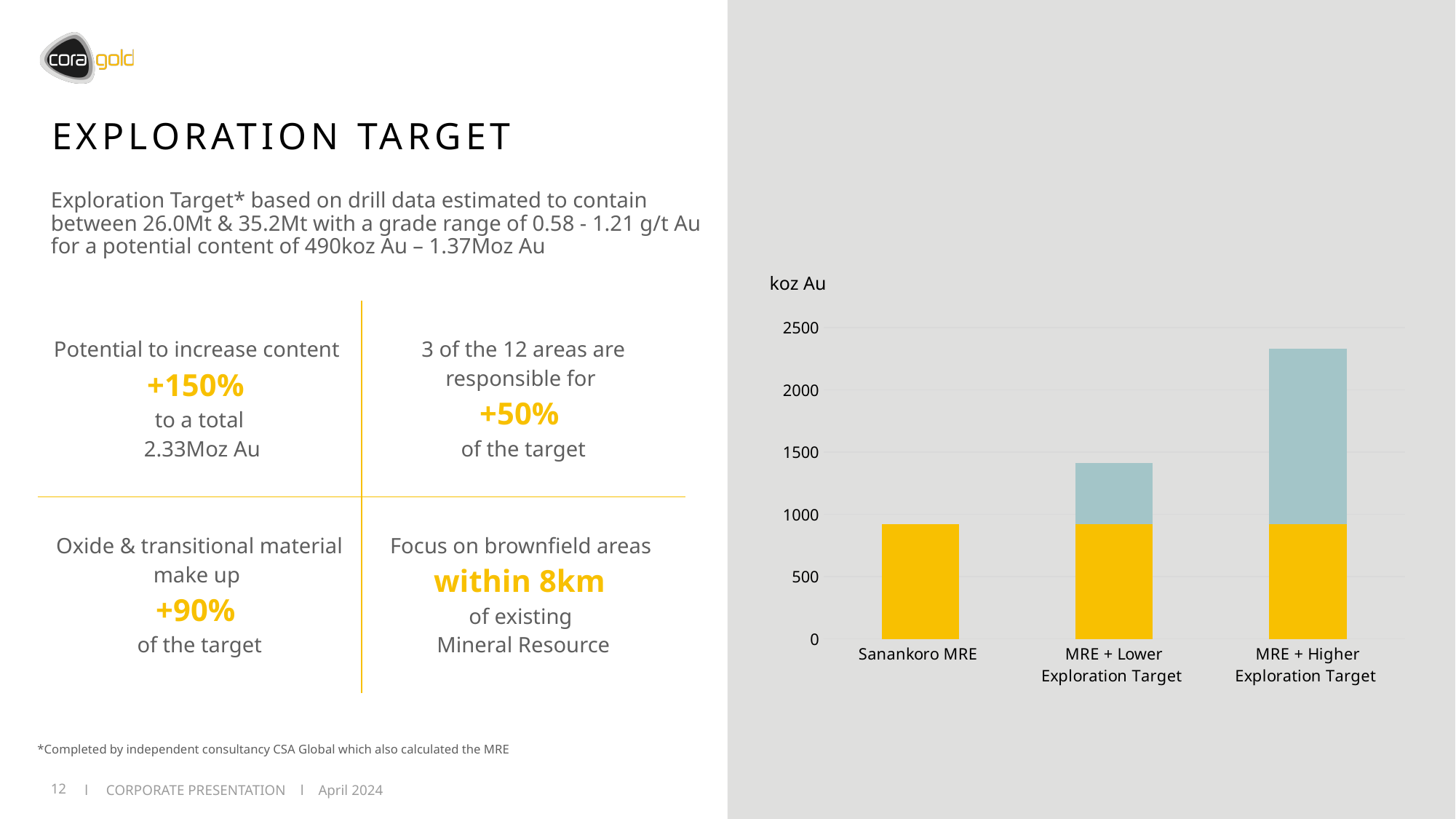
Do the total bar values rise or fall from left to right across the x axis? rise Is the total value for MRE + Lower Exploration Target greater or less than 1000? greater Which is larger: the total bar for MRE + Lower Exploration Target or the total bar for MRE + Higher Exploration Target? MRE + Higher Exploration Target What kind of chart is shown on the slide? bar chart Is the total value for MRE + Lower Exploration Target greater or less than 1500? less What unit label is shown above the y axis of the chart? koz Au Which category has the highest total bar in the chart? MRE + Higher Exploration Target Is the total value for MRE + Higher Exploration Target greater or less than 2000? greater Which category has the lowest bar in the chart? Sanankoro MRE What is the highest tick value shown on the y axis of the chart? 2500 How many categories are shown on the x axis of the chart? 3